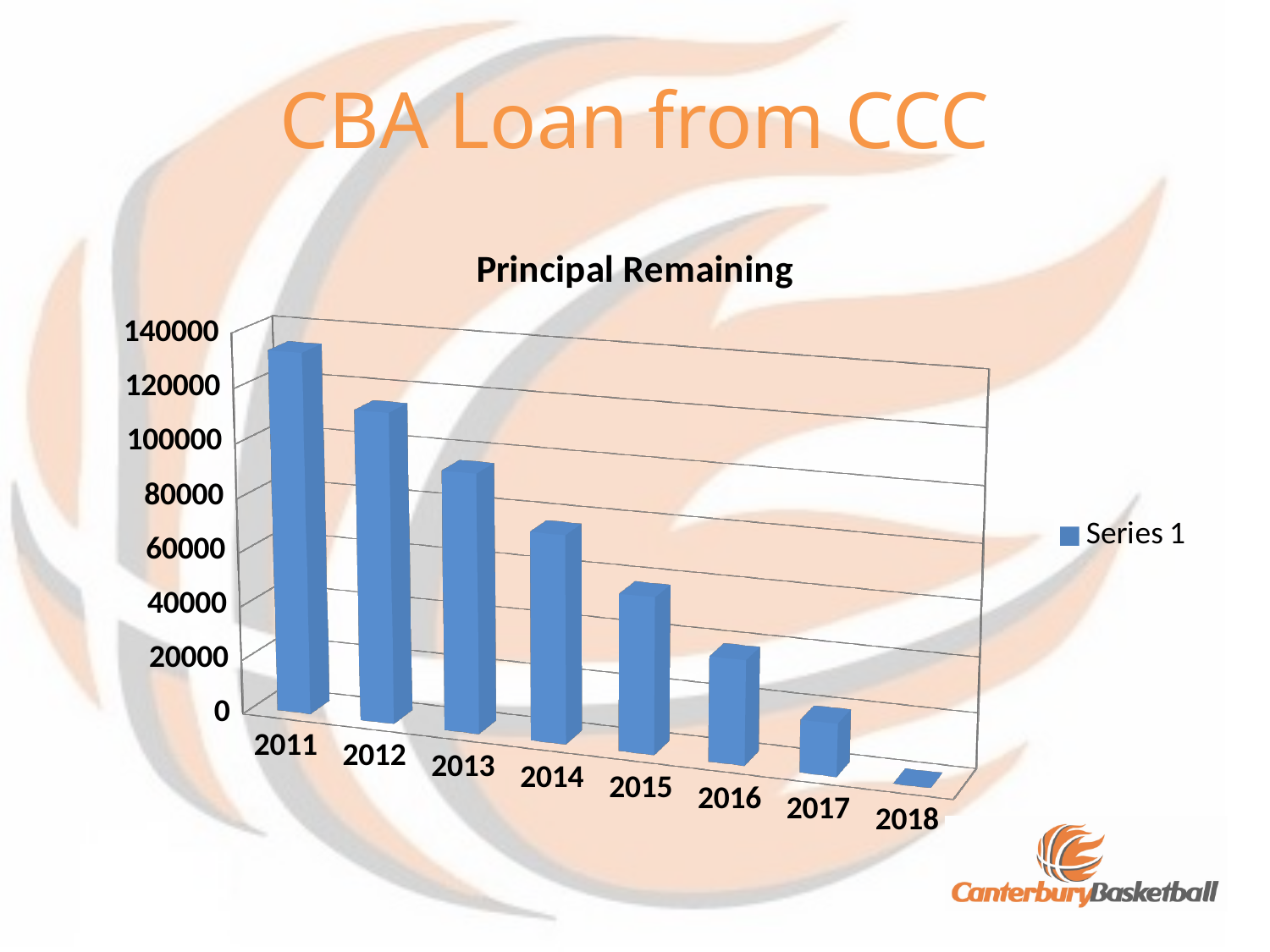
How many series does the legend list? 1 What is the legend entry for the series in the chart? Series 1 Is the value for 2015 greater or less than 60000? less Which year has the highest principal remaining? 2011 How many years are shown on the x axis of the chart? 8 Is the value for 2011 greater or less than 120000? greater What is the title of the chart? Principal Remaining Which year has a larger principal remaining, 2013 or 2016? 2013 Do the values rise or fall from 2011 to 2018? fall What kind of chart is shown on the slide? bar chart Which year has the lowest principal remaining? 2018